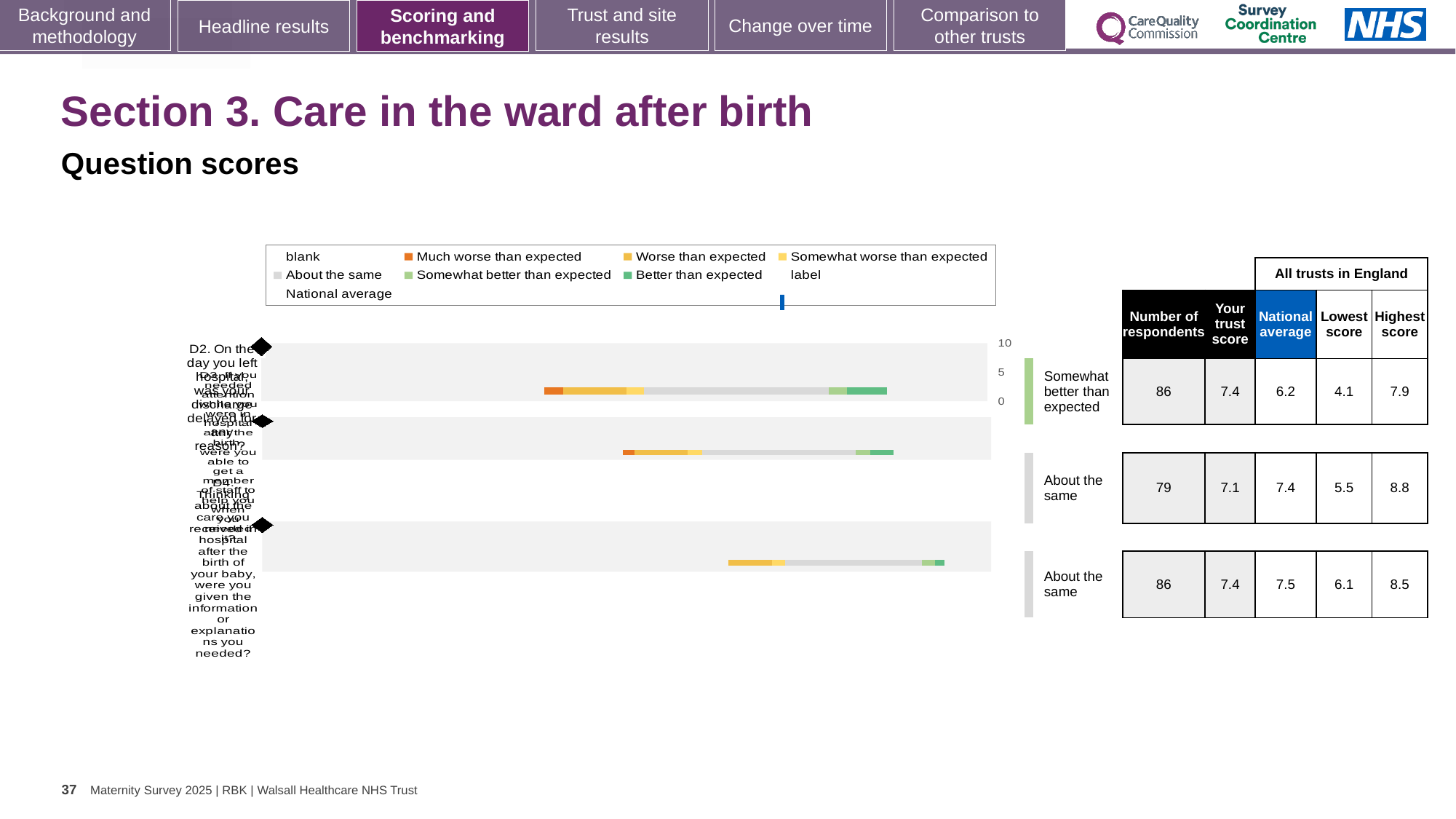
In the first (top) row of the table, what is the difference between 'Your trust score' and the national average? 1.2 What rating label is shown next to the first (top) bar? Somewhat better than expected Which row of the table has the lowest number of respondents? the second row, 79 What kind of chart is shown on the slide? bar chart What is the heading above the 'National average', 'Lowest score' and 'Highest score' columns in the table? All trusts in England In the table, what is the highest score for the third (bottom) row? 8.5 How many bars (questions) are plotted in the chart? 3 In the table, what is the lowest score for the first (top) row? 4.1 In the second row of the table, which is larger: 'Your trust score' or the national average? National average In the table, what is the number of respondents for the first (top) row? 86 Which row of the table has the highest national average? the third (bottom) row, 7.5 In the table, what is the 'Your trust score' value for the second row? 7.1